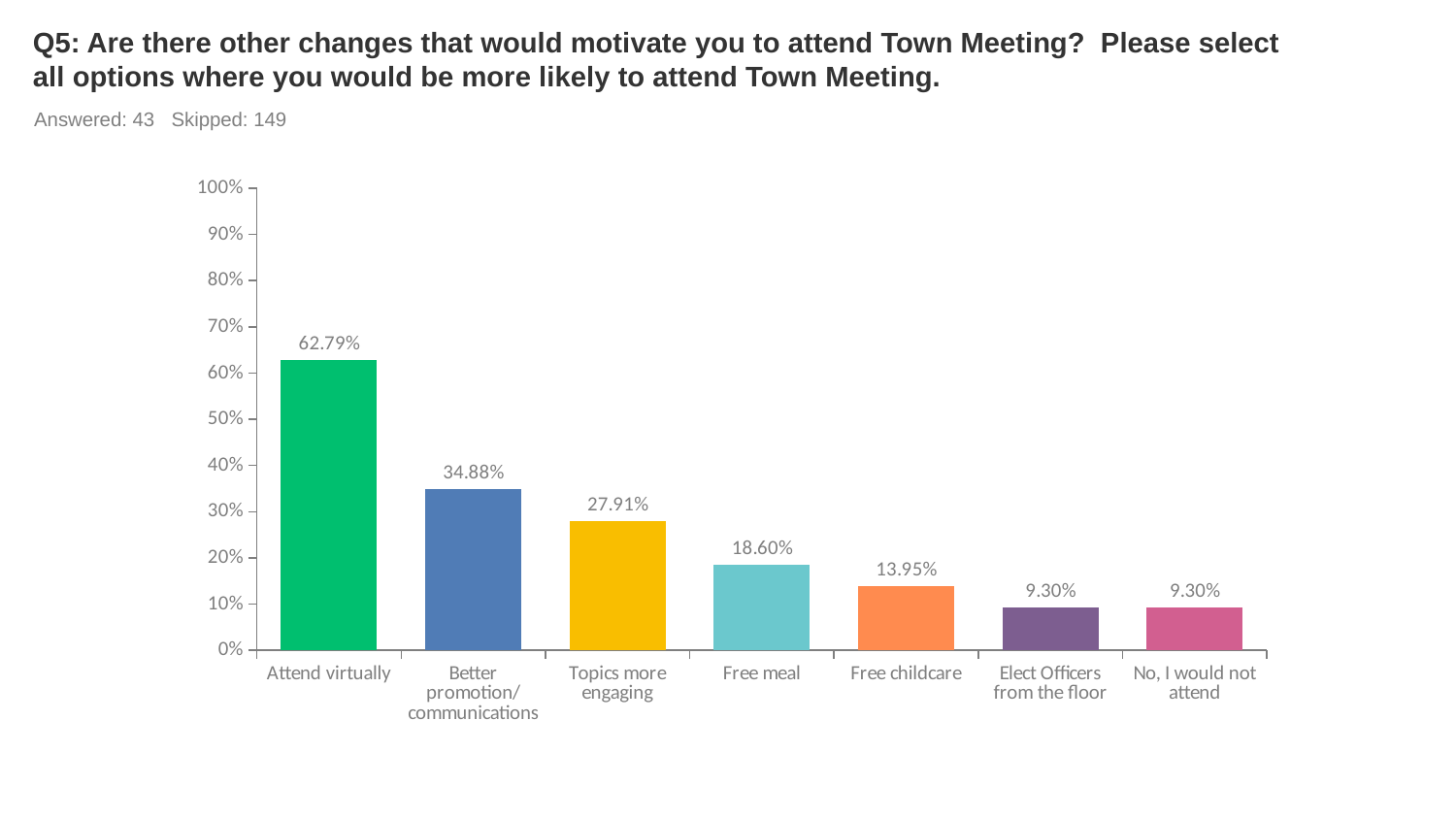
What is the value for "Free meal"? 18.60% How many categories are shown on the x axis? 7 What percentage of respondents selected "Attend virtually"? 62.79% Which category has the highest value? Attend virtually How many respondents answered this question according to the slide? 43 Which is larger, "Better promotion/communications" or "Topics more engaging"? Better promotion/communications What is the difference between "Topics more engaging" and "Free meal"? 9.31% What kind of chart is shown on the slide? Bar chart Do the values rise or fall from left to right along the x axis? Fall Is the value for "Free childcare" greater or less than 20%? less What is the value for "Free childcare"? 13.95% What is the difference between "Attend virtually" and "Better promotion/communications"? 27.91%